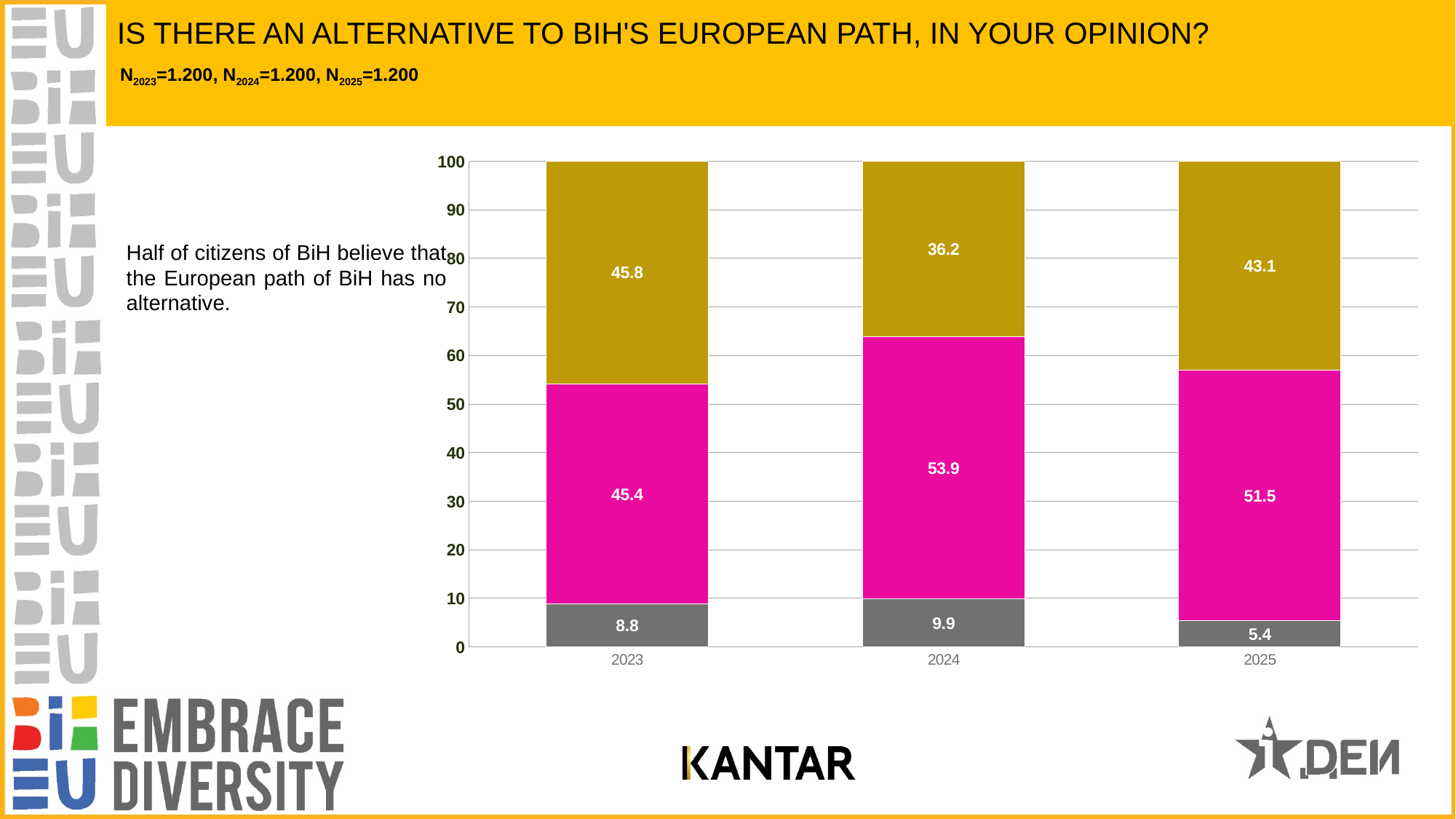
What is the value of the gold (top) segment for 2023? 45.8 In which year is the grey (bottom) segment the smallest? 2025 In which year is the magenta (middle) segment the largest? 2024 What is the difference between the magenta segment values for 2024 and 2023? 8.5 What is the title of the slide containing the chart? IS THERE AN ALTERNATIVE TO BIH'S EUROPEAN PATH, IN YOUR OPINION? What is the value of the grey (bottom) segment for 2025? 5.4 Which is larger for 2025: the magenta (middle) segment or the gold (top) segment? magenta (middle) segment In which year is the gold (top) segment the smallest? 2024 What is the total of the stacked bar for 2023? 100 What type of chart is shown on the slide? stacked bar chart What is the value of the magenta (middle) segment for 2024? 53.9 How many years (categories) are shown on the x axis of the chart? 3